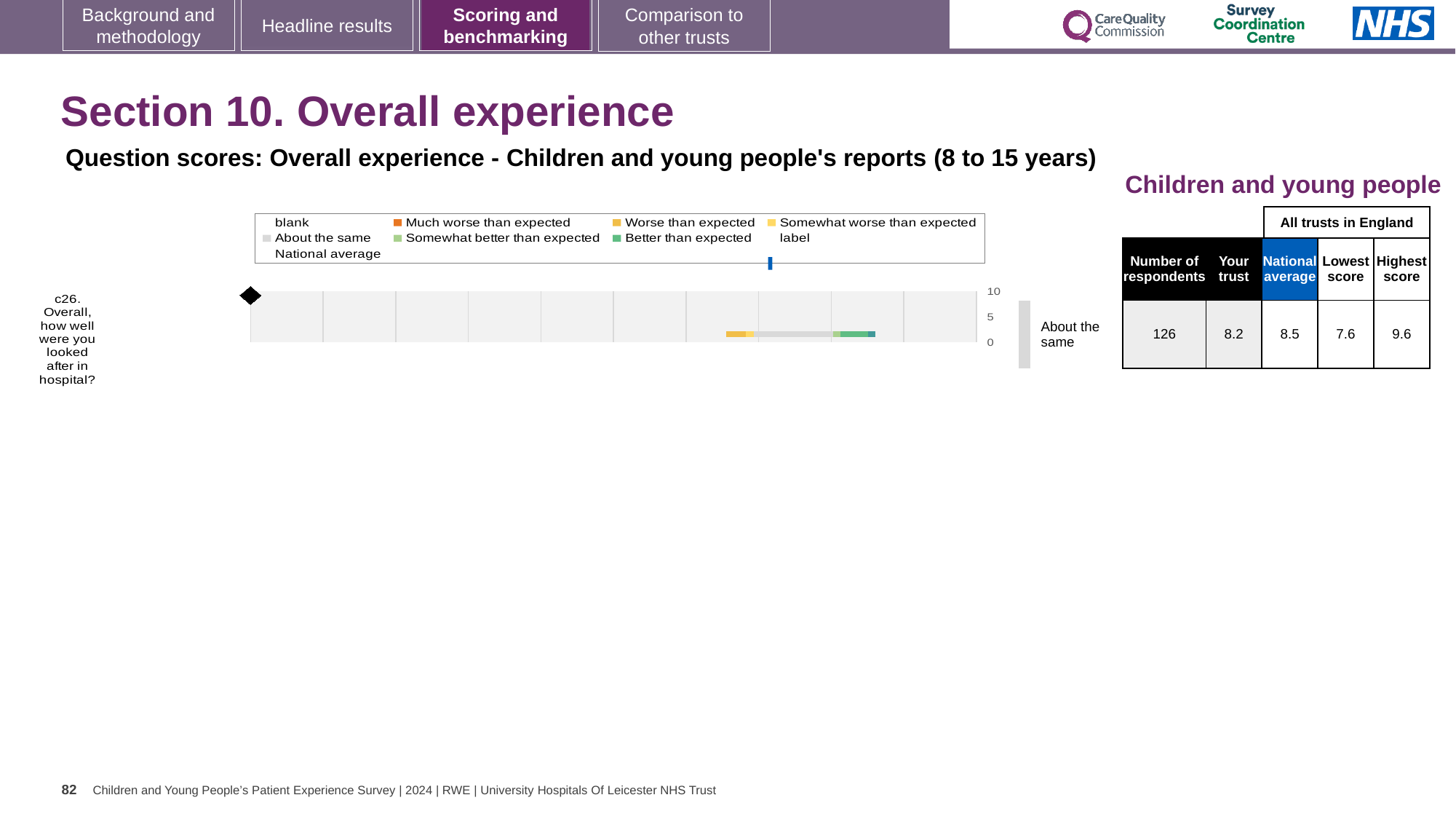
How many respondents answered question c26? 126 Which is larger for question c26: the trust's score or the national average? national average What benchmark category label is shown next to the bar for question c26? About the same What is the difference between the national average and the trust's score for question c26? 0.3 What is the maximum value shown on the chart's score axis? 10 What is the national average score for question c26? 8.5 What is the difference between the highest score and the lowest score for question c26? 2.0 What is the highest score among all trusts in England for question c26? 9.6 What is the 'Your trust' score for question c26, 'Overall, how well were you looked after in hospital?'? 8.2 How many questions are plotted in the chart? 1 What is the lowest score among all trusts in England for question c26? 7.6 What kind of chart is used to show the score for question c26? bar chart